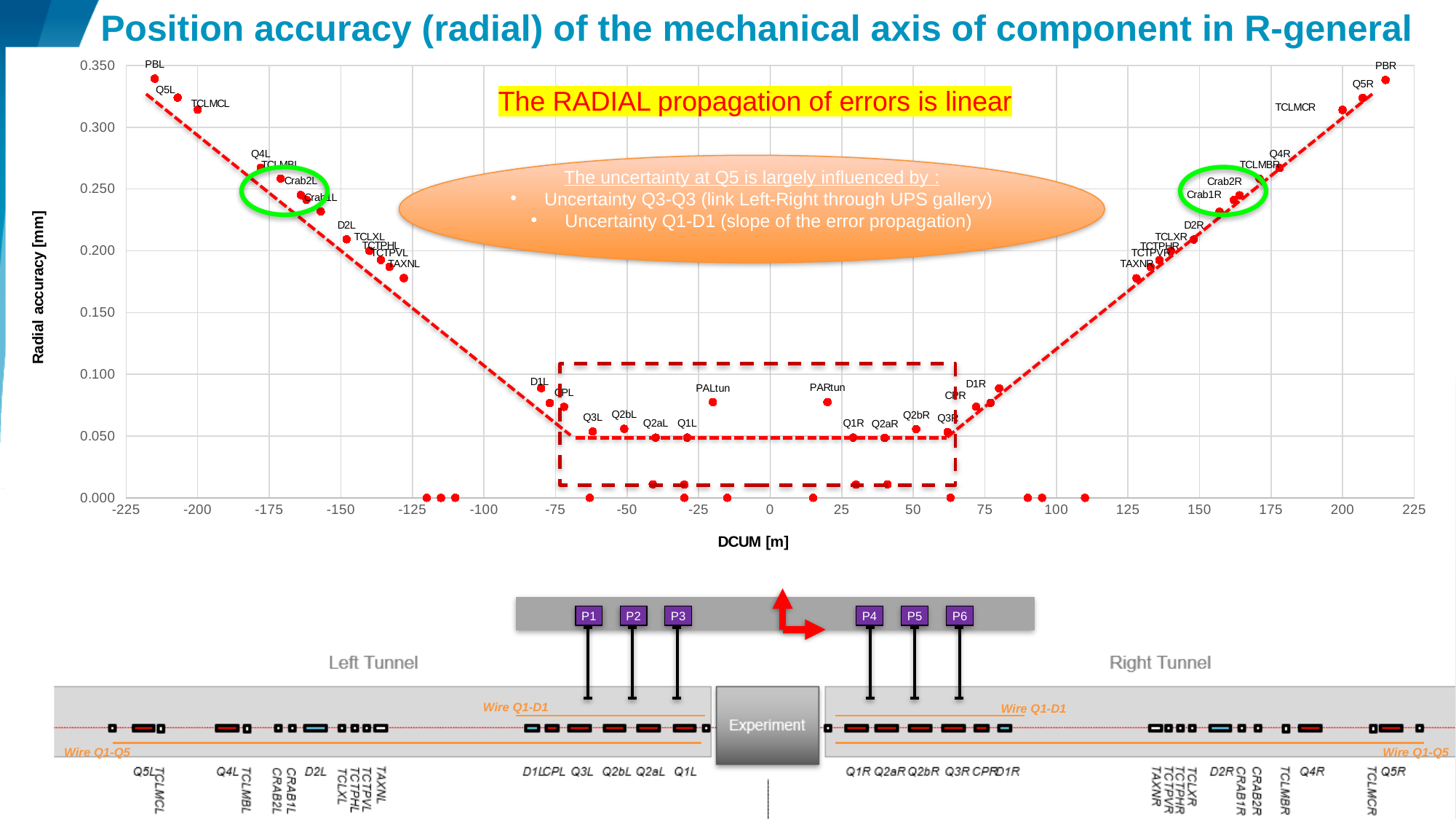
Which has the larger radial accuracy value, PBL or Q1L? PBL Is the radial accuracy value for PBL greater or less than 0.300? greater As DCUM increases from 0 to 225 m, do the radial accuracy values rise or fall? rise Which has the larger radial accuracy value, D1L or Q5L? Q5L Is the radial accuracy value for PALtun greater or less than 0.100? less What statement is highlighted in yellow on the chart? The RADIAL propagation of errors is linear Is the radial accuracy value for D2R greater or less than 0.250? less Which has the larger radial accuracy value, Q4L or D2L? Q4L What is the title of the vertical axis of the chart? Radial accuracy [mm] What kind of chart is shown on the slide? scatter chart